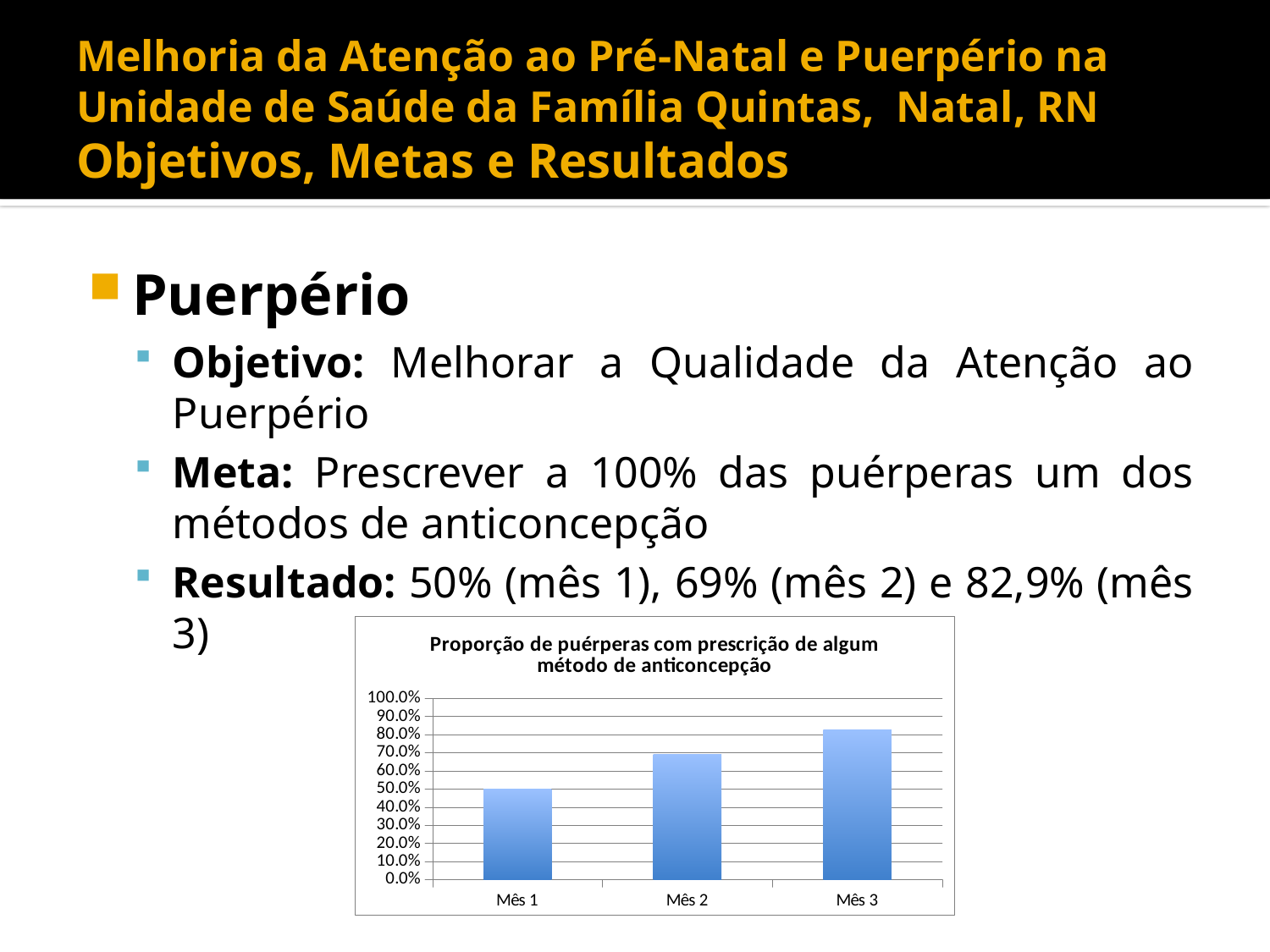
Which month has the highest value in the chart? Mês 3 Do the values rise or fall from Mês 1 to Mês 3? rise How many categories (months) are shown on the x axis of the chart? 3 Is the value for Mês 3 greater or less than 90.0%? less What is the value for Mês 1 in the chart? 50% Is the value for Mês 2 greater or less than 60.0%? greater What is the title of the chart? Proporção de puérperas com prescrição de algum método de anticoncepção Which is larger, the value for Mês 1 or the value for Mês 2? Mês 2 What is the value for Mês 2 in the chart? 69% What is the value for Mês 3 in the chart? 82,9% What type of chart is shown on the slide? bar chart Which month has the lowest value in the chart? Mês 1